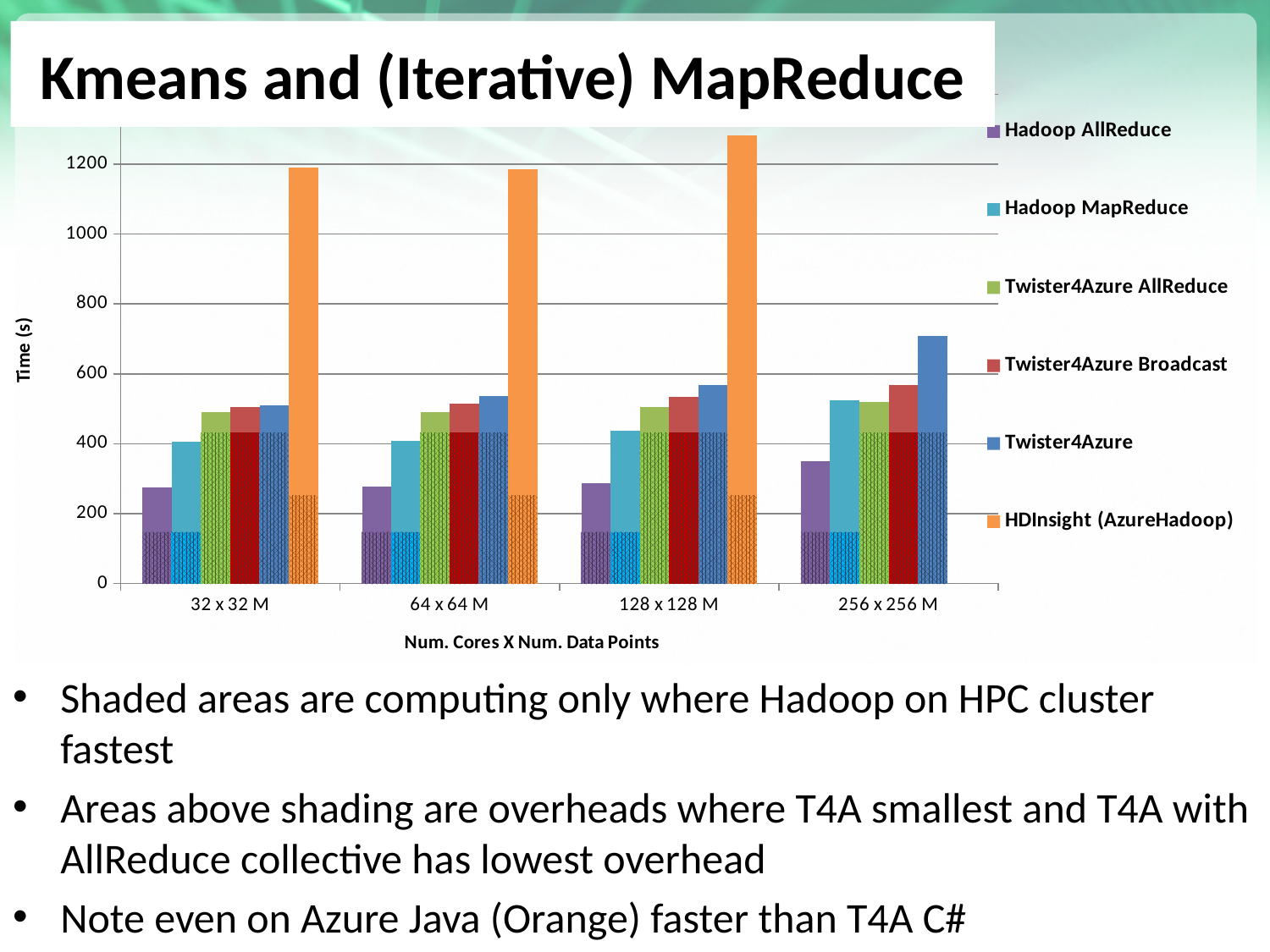
Is the value for HDInsight (AzureHadoop) at 32 x 32 M greater or less than 1000? greater Is the value for Hadoop AllReduce at 32 x 32 M greater or less than 400? less How many series does the legend list? 6 At 32 x 32 M, which is larger: Hadoop MapReduce or Twister4Azure AllReduce? Twister4Azure AllReduce For which category is the Twister4Azure value highest? 256 x 256 M Is the value for Twister4Azure at 256 x 256 M greater or less than 600? greater How many categories are shown on the x axis? 4 What is the label of the x axis? Num. Cores X Num. Data Points Which series has the lowest value at 32 x 32 M? Hadoop AllReduce What kind of chart is shown on the slide? Bar chart Which series has the highest value at 32 x 32 M? HDInsight (AzureHadoop) What is the label of the y axis? Time (s)